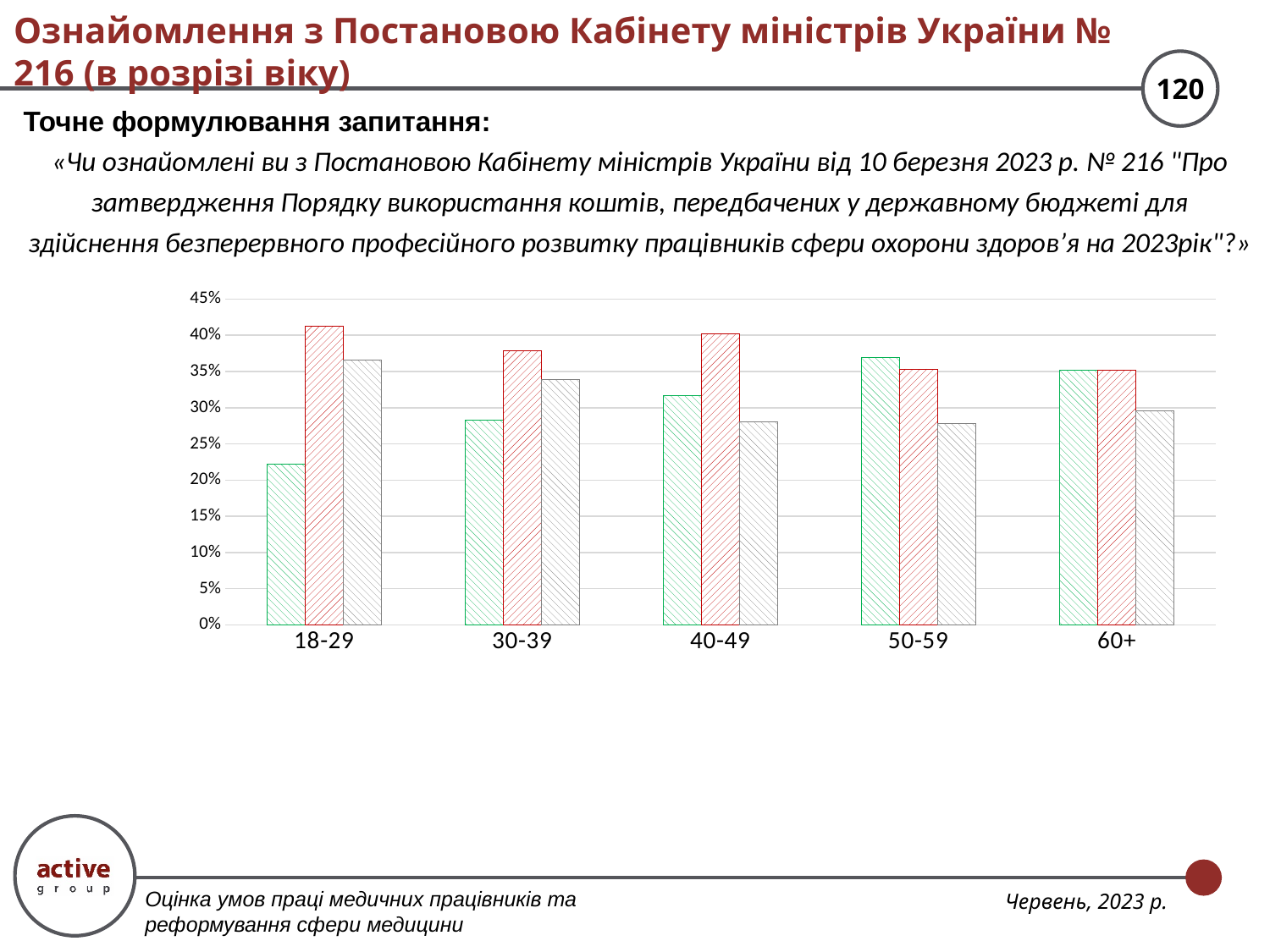
Is the value of the green bar for the 50-59 age group greater or less than 35%? greater How many bars are plotted for each age group in the chart? 3 What is the highest value shown on the chart's vertical axis? 45% For the 18-29 age group, which bar is larger, the red one or the green one? red Which age group has the highest green bar? 50-59 Is the value of the red bar for the 18-29 age group greater or less than 40%? greater Is the value of the green bar for the 18-29 age group greater or less than 25%? less Which age group has the lowest green bar? 18-29 What kind of chart is shown on the slide? bar chart For the 40-49 age group, which bar is larger, the red one or the grey one? red How many age groups are shown on the x axis of the chart? 5